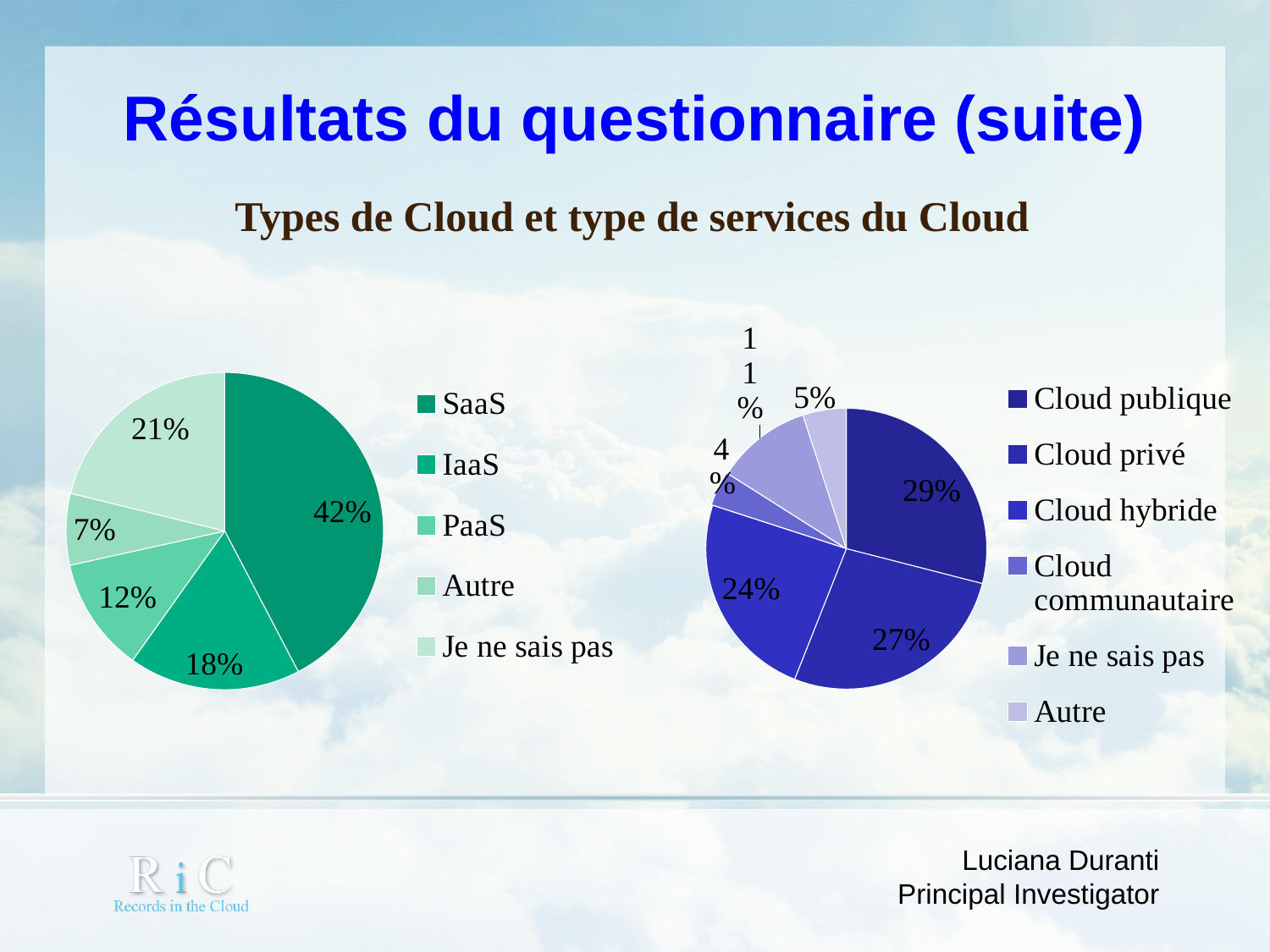
In the right pie chart, what share does Cloud hybride have? 24% What type of chart is used on the left side of the slide? Pie chart In the left pie chart, which category has the largest slice? SaaS In the left pie chart, what is the difference between the SaaS and IaaS shares? 24% In the left pie chart, what share does 'Je ne sais pas' have? 21% In the left pie chart, which category has the smallest slice? Autre In the left pie chart, what share does SaaS have? 42% In the left pie chart, what share does IaaS have? 18% In the right pie chart, which is larger, Cloud privé or Cloud hybride? Cloud privé In the right pie chart, what share does Cloud publique have? 29% How many categories does the legend of the right pie chart list? 6 In the right pie chart, which category has the smallest slice? Cloud communautaire